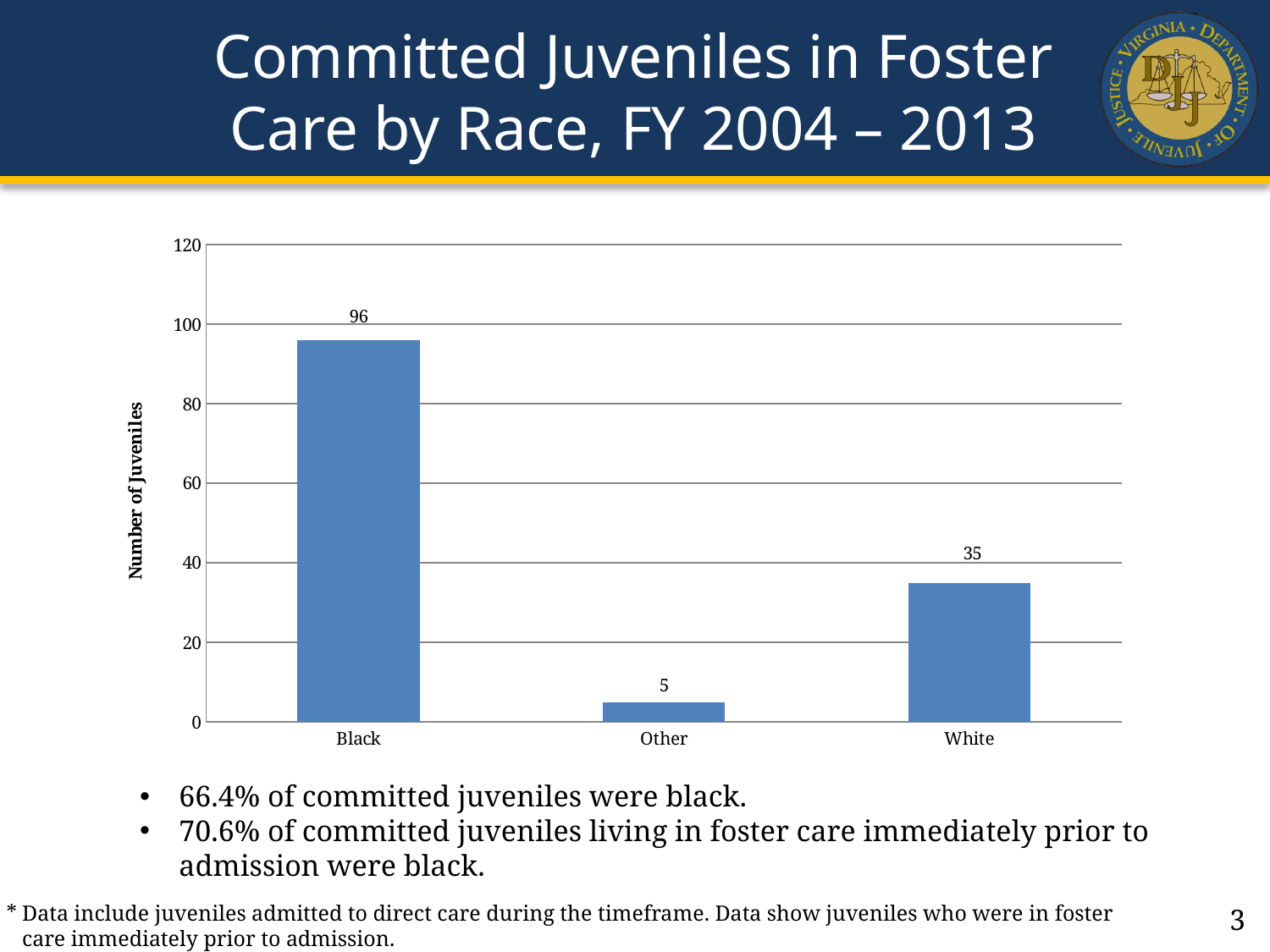
Is the value for Black greater or less than 80? greater What is the number of juveniles for the Black category? 96 What kind of chart is shown on the slide? Bar chart What is the difference between the number of juveniles for White and Other? 30 What is the number of juveniles for the White category? 35 How many race categories are shown on the x axis? 3 What is the label of the y axis? Number of Juveniles Which race category has the lowest number of juveniles? Other Which race category has the highest number of juveniles? Black What is the number of juveniles for the Other category? 5 What is the difference between the number of juveniles for Black and White? 61 Which is larger, the value for White or the value for Other? White